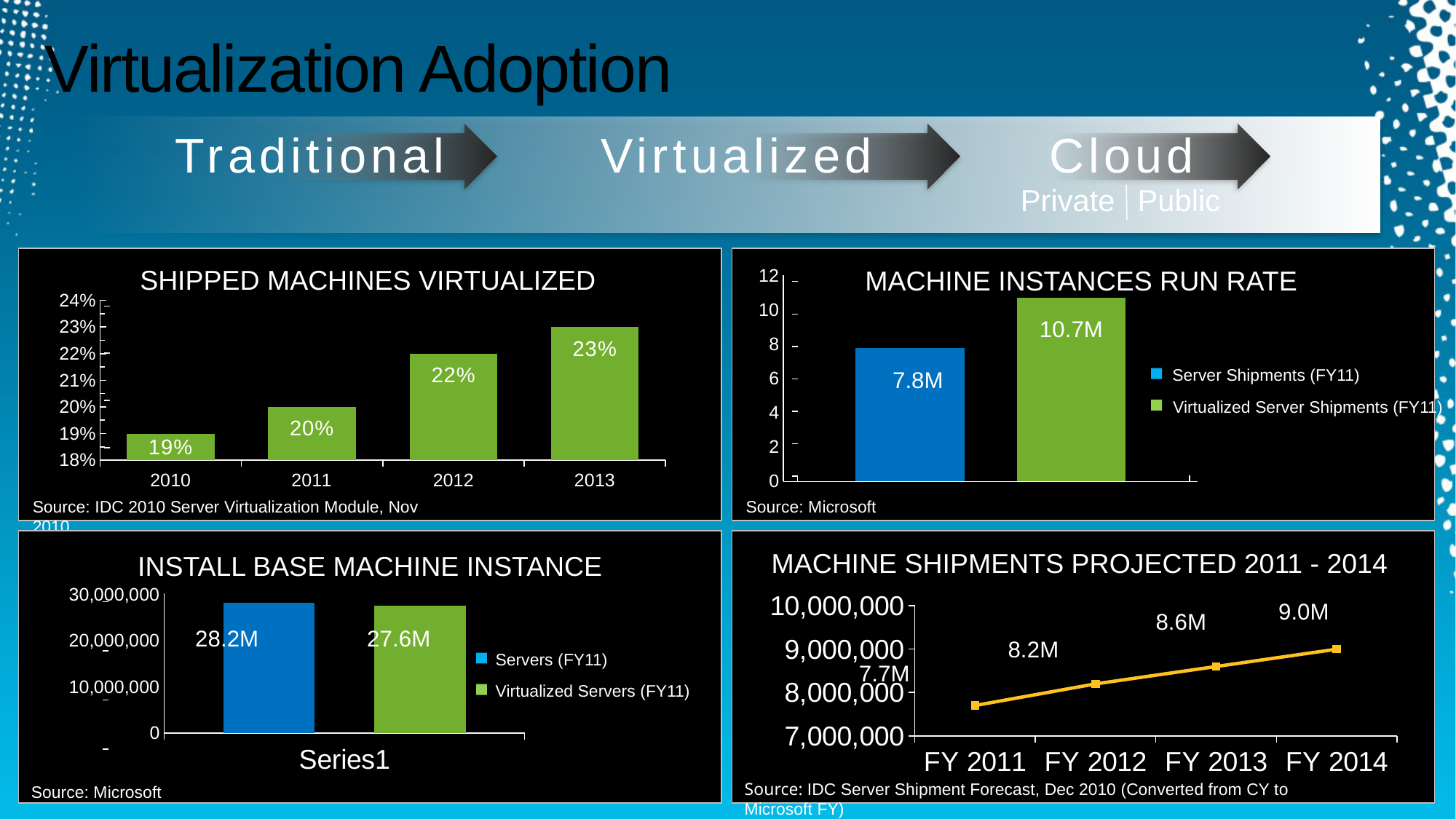
In the SHIPPED MACHINES VIRTUALIZED chart, which year has the lowest value? 2010 In the MACHINE INSTANCES RUN RATE chart, which is larger: Server Shipments (FY11) or Virtualized Server Shipments (FY11)? Virtualized Server Shipments (FY11) In the SHIPPED MACHINES VIRTUALIZED chart, what is the value for 2012? 22% In the INSTALL BASE MACHINE INSTANCE chart, what is the difference between Servers (FY11) and Virtualized Servers (FY11)? 0.6M In the MACHINE INSTANCES RUN RATE chart, what is the value for Virtualized Server Shipments (FY11)? 10.7M In the MACHINE SHIPMENTS PROJECTED 2011 - 2014 chart, which fiscal year has the highest value? FY 2014 In the INSTALL BASE MACHINE INSTANCE chart, what is the value for Servers (FY11)? 28.2M In the MACHINE SHIPMENTS PROJECTED 2011 - 2014 chart, what is the value for FY 2013? 8.6M In the SHIPPED MACHINES VIRTUALIZED chart, how many years are shown on the x axis? 4 In the SHIPPED MACHINES VIRTUALIZED chart, do the values rise or fall from 2010 to 2013? rise What kind of chart is the MACHINE SHIPMENTS PROJECTED 2011 - 2014 chart? line chart In the MACHINE INSTANCES RUN RATE chart, how many series does the legend list? 2